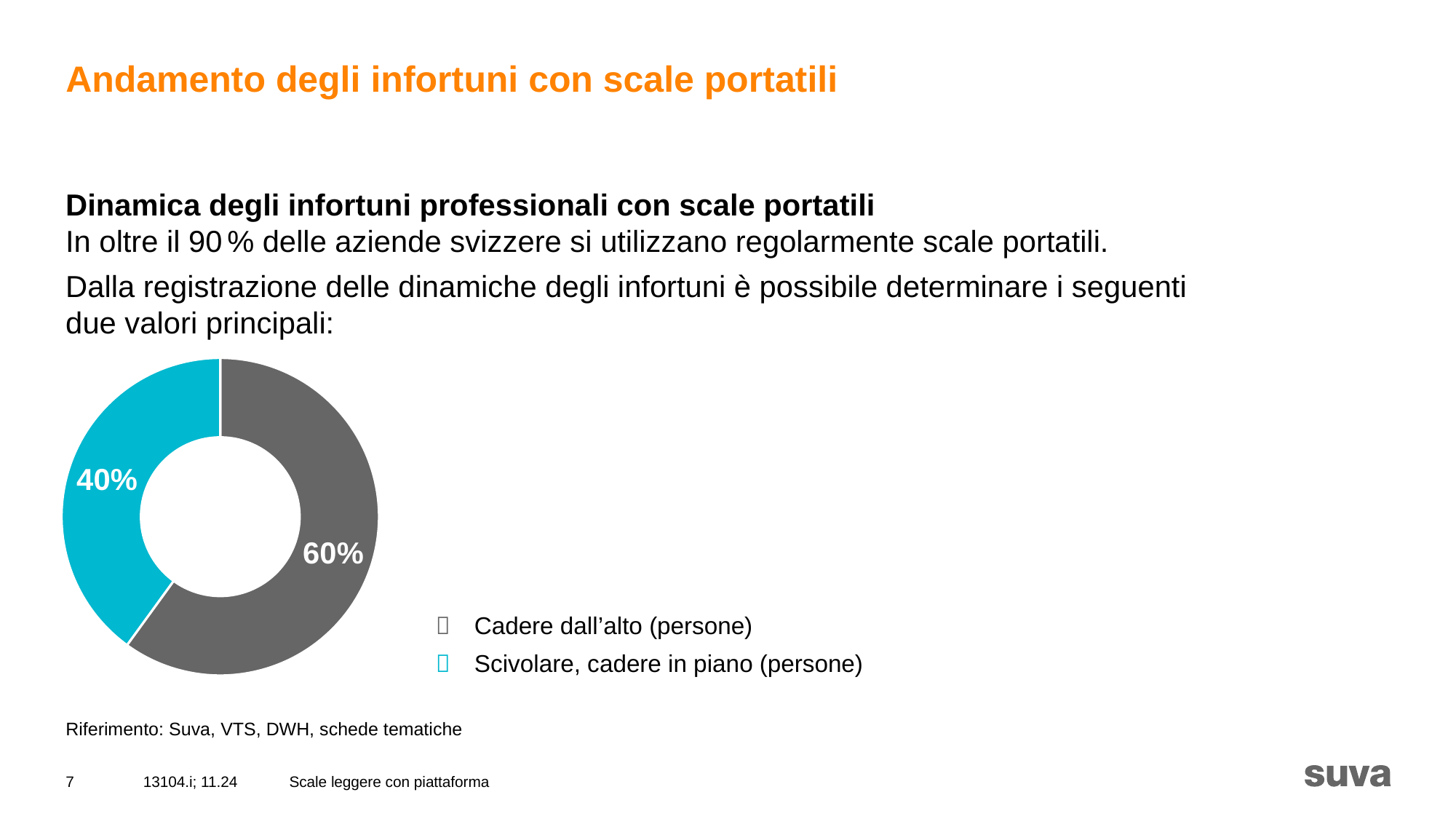
Which category has the largest slice in the chart? Cadere dall'alto (persone) What is the total of the two slices shown in the chart? 100% What share of the chart does "Scivolare, cadere in piano (persone)" represent? 40% Which category has the smallest slice in the chart? Scivolare, cadere in piano (persone) Which is larger: the slice for "Cadere dall'alto (persone)" or the slice for "Scivolare, cadere in piano (persone)"? Cadere dall'alto (persone) What colour is the slice for "Cadere dall'alto (persone)"? Grey What is the difference in percentage points between the "Cadere dall'alto (persone)" slice and the "Scivolare, cadere in piano (persone)" slice? 20 percentage points What kind of chart is shown on the slide? Donut (pie) chart How many slices does the chart have? 2 How many entries does the chart legend list? 2 What colour is the slice for "Scivolare, cadere in piano (persone)"? Cyan (light blue) What share of the chart does "Cadere dall'alto (persone)" represent? 60%